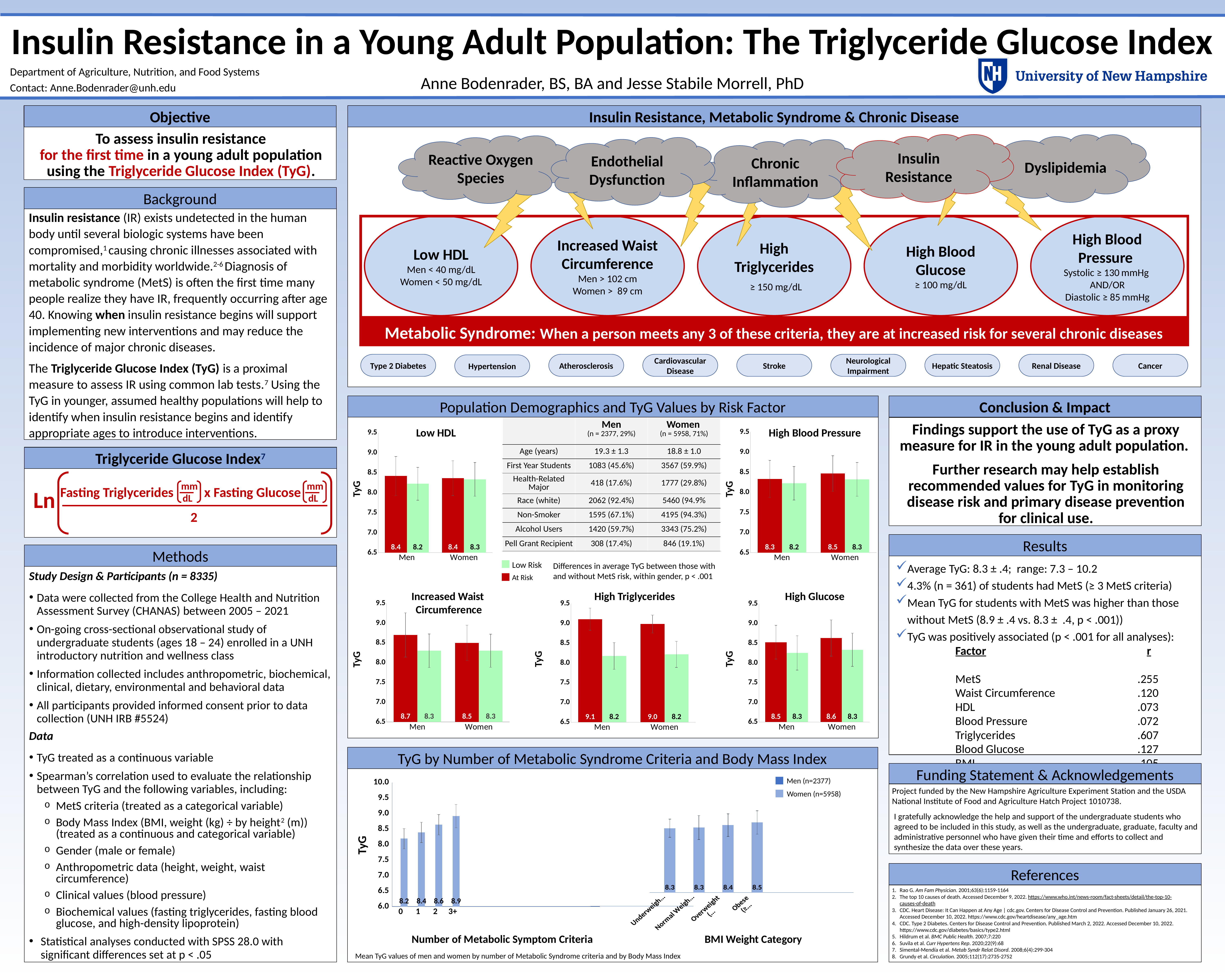
In the High Triglycerides chart, what is the difference between the at-risk and low-risk TyG values for men? 0.9 In the TyG by Number of Metabolic Syndrome Criteria and Body Mass Index chart, which number of metabolic symptom criteria has the lowest TyG value? 0 In the Increased Waist Circumference chart, what is the TyG value for men at risk? 8.7 In the TyG by Number of Metabolic Syndrome Criteria and Body Mass Index chart, what is the TyG value for 3+ metabolic symptom criteria? 8.9 In the TyG by Number of Metabolic Syndrome Criteria and Body Mass Index chart, do TyG values rise or fall as the number of metabolic symptom criteria increases? rise In the High Blood Pressure chart, what is the difference between the at-risk and low-risk TyG values for women? 0.2 In the Low HDL chart, what is the TyG value for women at low risk? 8.3 In the Increased Waist Circumference chart, which is larger: the at-risk TyG value for men or for women? men What kind of chart is the High Glucose chart? bar chart In the TyG by Number of Metabolic Syndrome Criteria and Body Mass Index chart, what is the TyG value for the Obese BMI category? 8.5 In the High Glucose chart, what is the TyG value for women at risk? 8.6 In the High Triglycerides chart, what is the TyG value for men at risk? 9.1